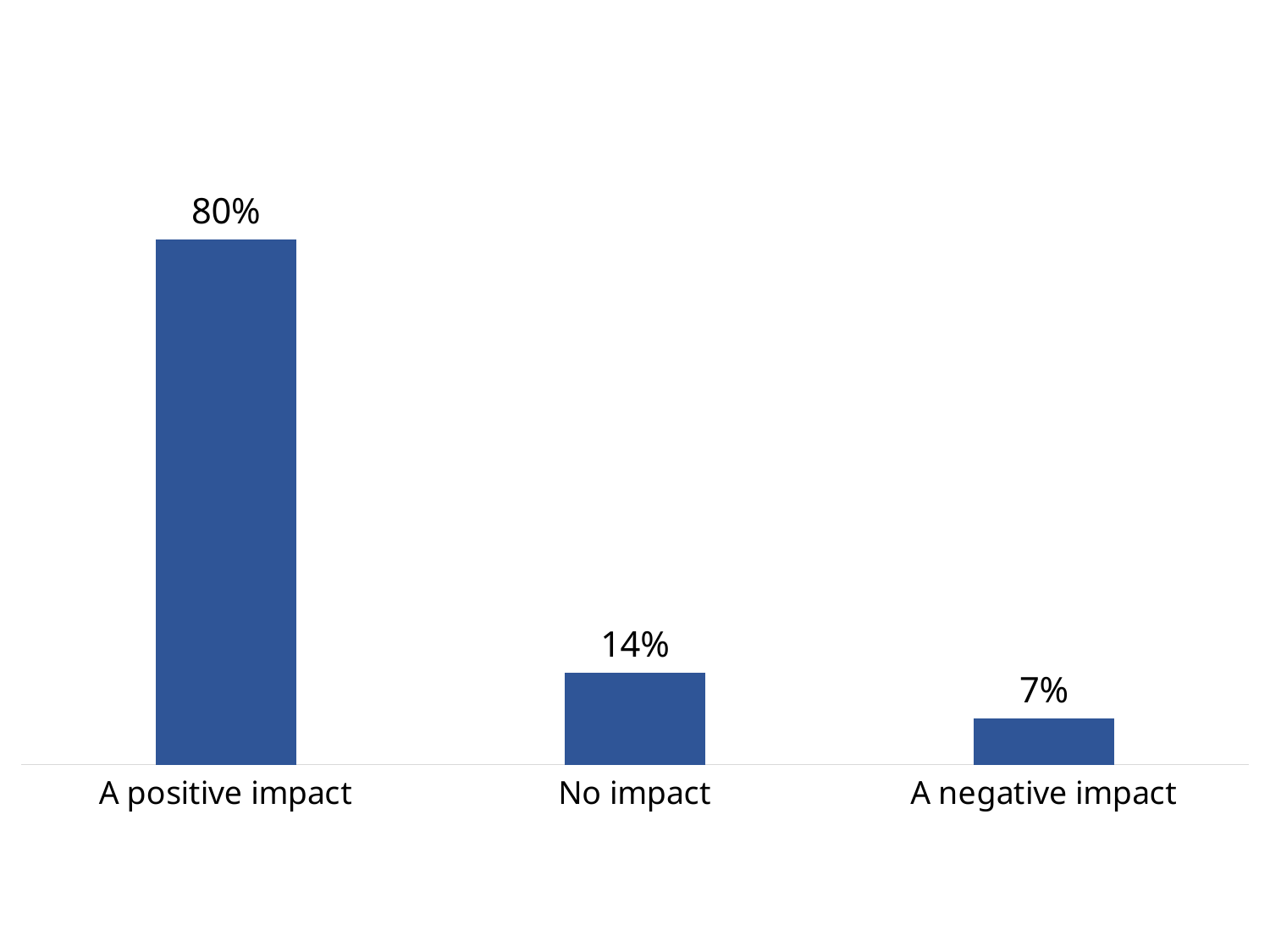
What is the value for "A negative impact"? 7% What colour are the bars in the chart? Blue What is the value for "No impact"? 14% What kind of chart is shown on the slide? Bar chart What is the difference between the values for "No impact" and "A negative impact"? 7% Do the values rise or fall from left to right across the categories? Fall What is the difference between the values for "A positive impact" and "No impact"? 66% Which category has the lowest value? A negative impact Which category has the highest value? A positive impact How many categories are shown in the chart? 3 What is the value for "A positive impact"? 80% Which is larger, the value for "No impact" or the value for "A negative impact"? No impact